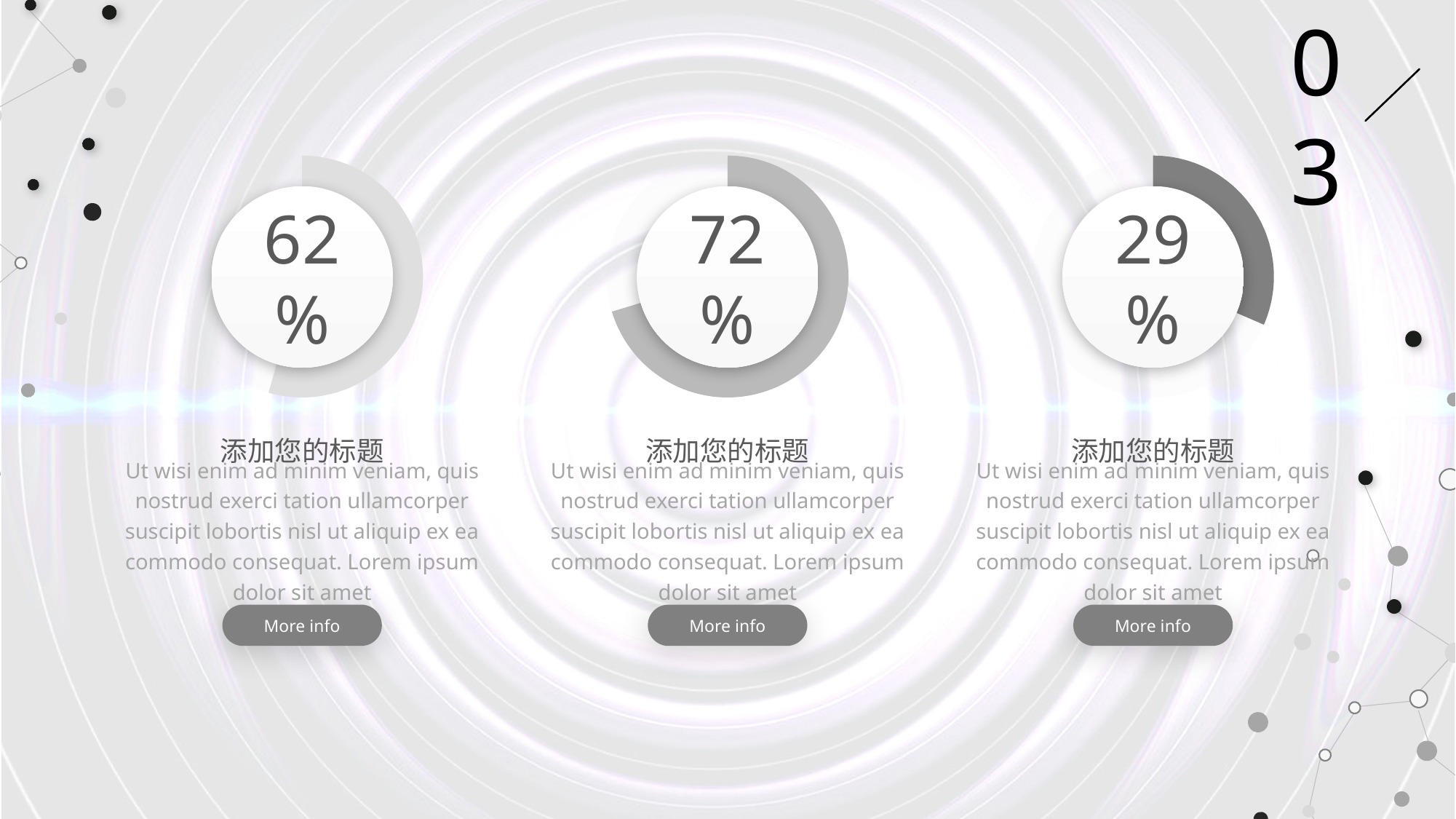
What kind of chart is used to display the percentages on the slide? Circular progress (ring) charts Which of the three circular charts shows the highest percentage? The middle one (72%) Which of the three circular charts shows the lowest percentage? The right one (29%) What value is shown in the left circular chart? 62% Which is larger, the value in the left chart or the value in the right chart? The left chart (62%) What is the difference between the left chart's value and the right chart's value? 33% Is the value in the right circular chart greater or less than 50%? less What value is shown in the middle circular chart? 72% What value is shown in the right circular chart? 29% How many circular percentage charts are on the slide? 3 What is the label on the button below each circular chart? More info What is the difference between the middle chart's value and the left chart's value? 10%